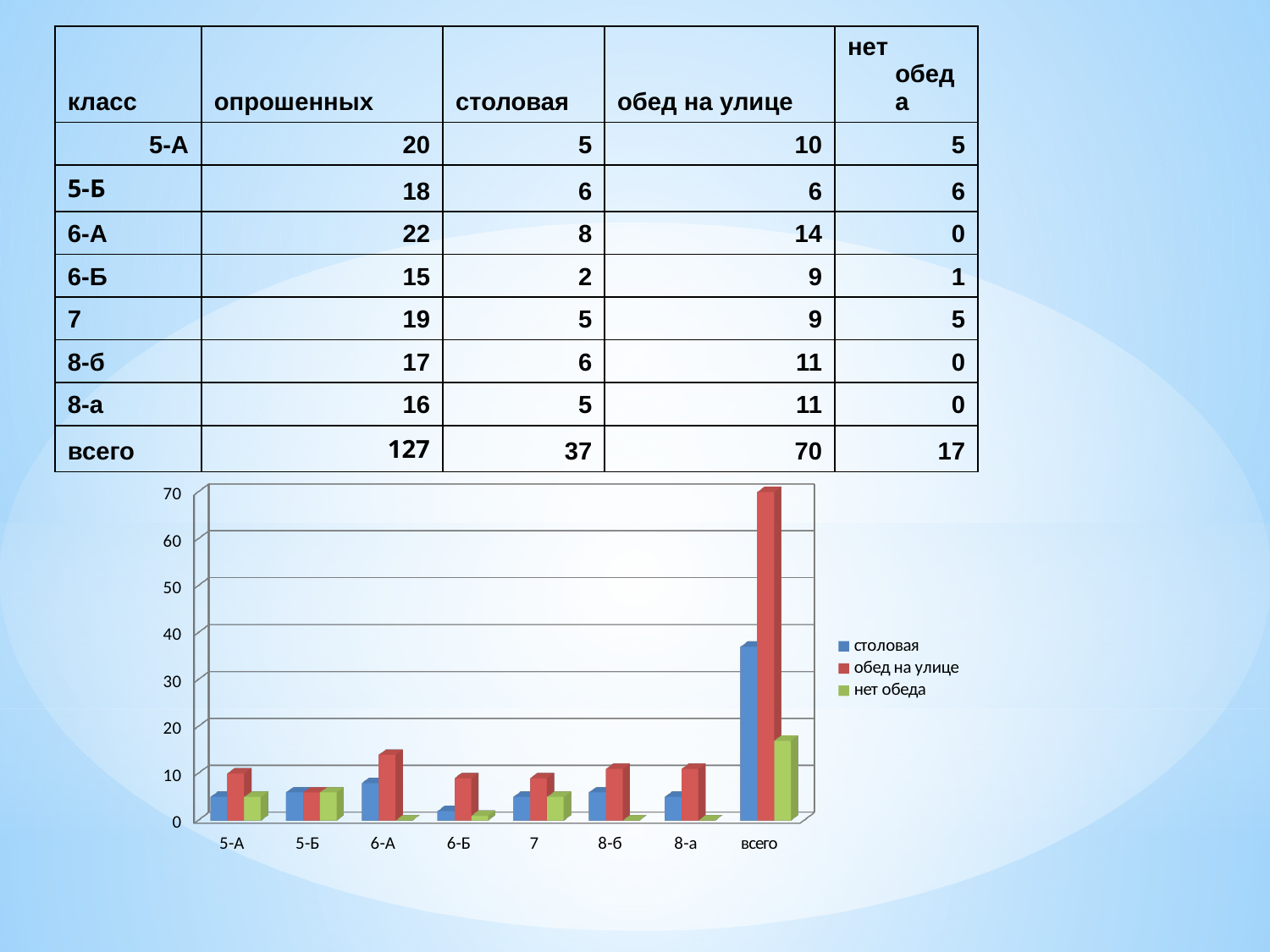
Is the value for 6-А in the series 'обед на улице' greater or less than 10? greater What is the value of 'нет обеда' for the category 'всего'? 17 What is the difference between 'обед на улице' and 'столовая' for the category 'всего'? 33 What are the three entries listed in the chart legend? столовая, обед на улице, нет обеда What is the value of 'столовая' for the category 'всего'? 37 What kind of chart is shown on the slide? bar chart How many categories are shown along the x axis of the chart? 8 How many series does the chart legend list? 3 Is the value for 'всего' in the series 'столовая' greater or less than 30? greater Which category has the highest value for the series 'обед на улице'? всего For the category 5-А, which is larger: 'столовая' or 'обед на улице'? обед на улице Among the individual classes (excluding 'всего'), which has the lowest value for 'столовая'? 6-Б